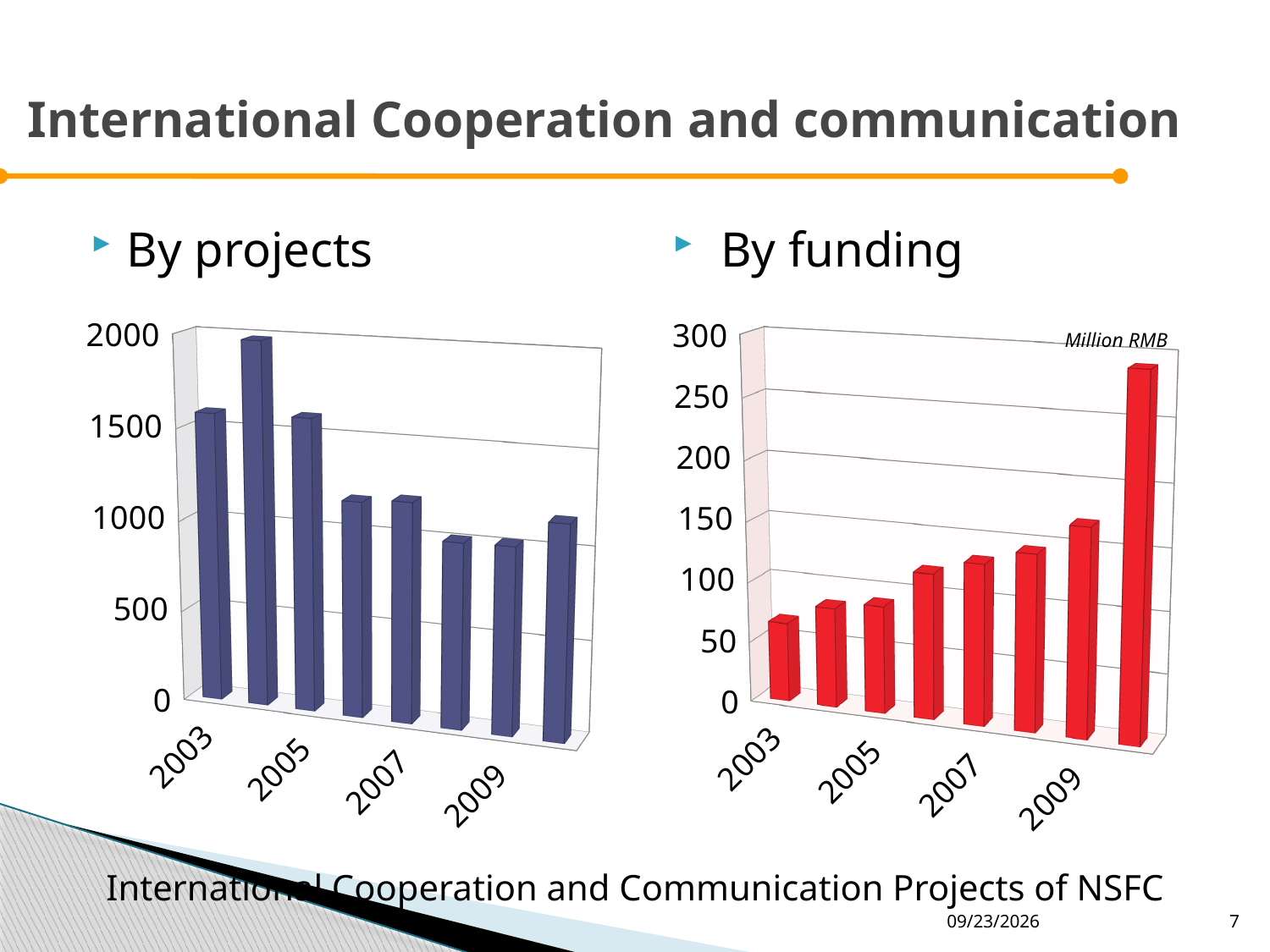
In the 'By projects' chart, is the value for 2003 greater or less than 1500? greater What kind of chart is the 'By funding' chart? bar chart In the 'By projects' chart, which is larger, the value for 2003 or the value for 2009? 2003 In the 'By funding' chart, do the values generally rise or fall from 2003 onwards? rise How many bars are plotted in the 'By projects' chart? 8 What kind of chart is the 'By projects' chart? bar chart How many bars are plotted in the 'By funding' chart? 8 What unit is shown on the 'By funding' chart? Million RMB In the 'By funding' chart, is the value for 2007 greater or less than 100? greater In the 'By funding' chart, which year has the lowest value? 2003 In the 'By funding' chart, is the value for 2003 greater or less than 100? less